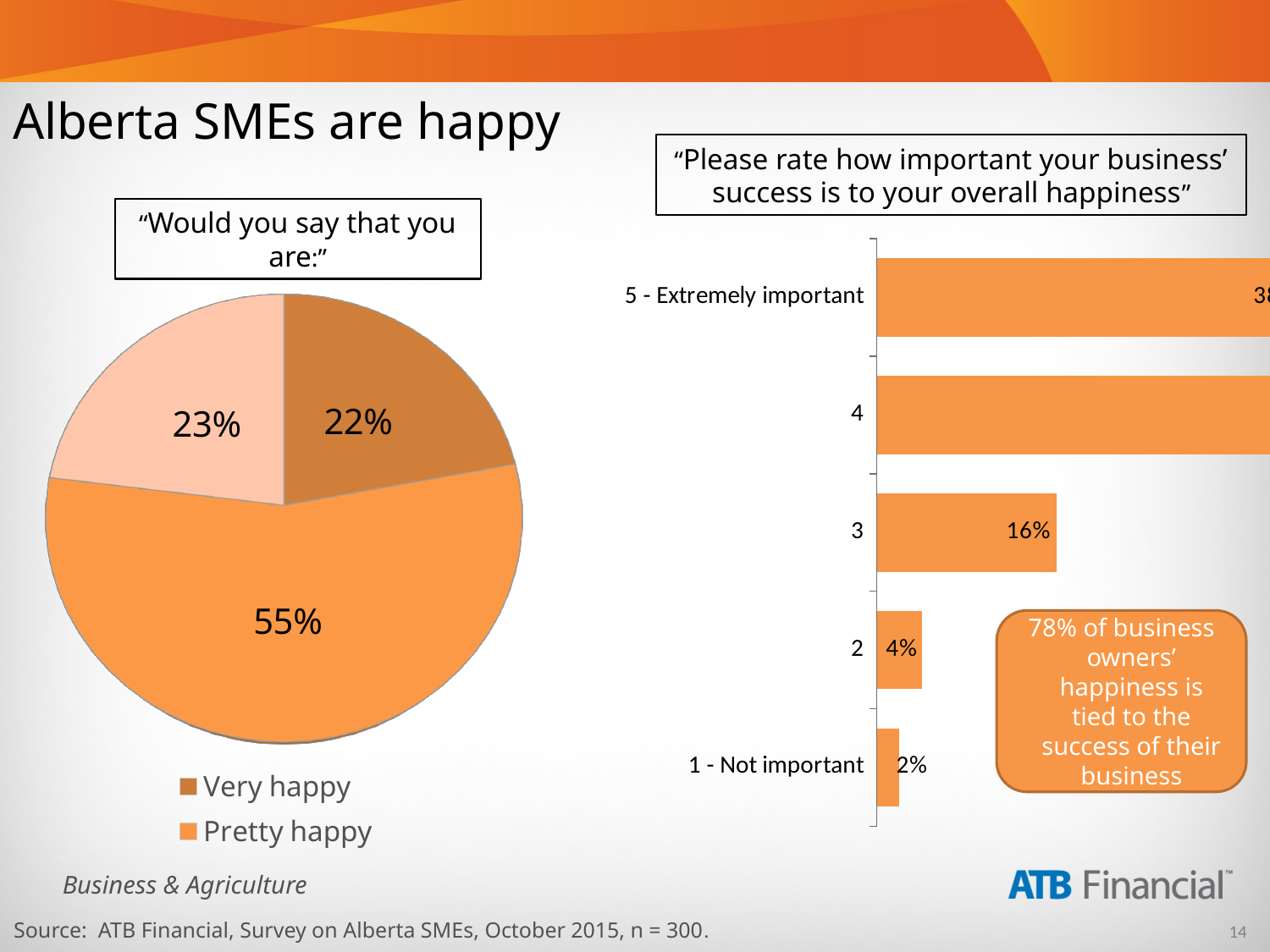
In the bar chart on the right, which category has the lowest value? 1 - Not important In the pie chart on the left, which legend category has the largest slice? Pretty happy In the bar chart on the right, how many rating categories are shown? 5 In the pie chart on the left, how many percentage points larger is the Pretty happy slice than the Very happy slice? 33 percentage points In the pie chart titled "Would you say that you are:", what percentage of respondents said they are Very happy? 22% In the bar chart on the right, what is the value for "1 - Not important"? 2% In the pie chart titled "Would you say that you are:", what percentage of respondents said they are Pretty happy? 55% What kind of chart is the chart on the right of the slide? Bar chart In the bar chart titled "Please rate how important your business' success is to your overall happiness", what is the value for rating 3? 16% What kind of chart is the chart on the left of the slide? Pie chart In the bar chart on the right, what is the value for rating 2? 4% How many slices does the pie chart on the left have? 3